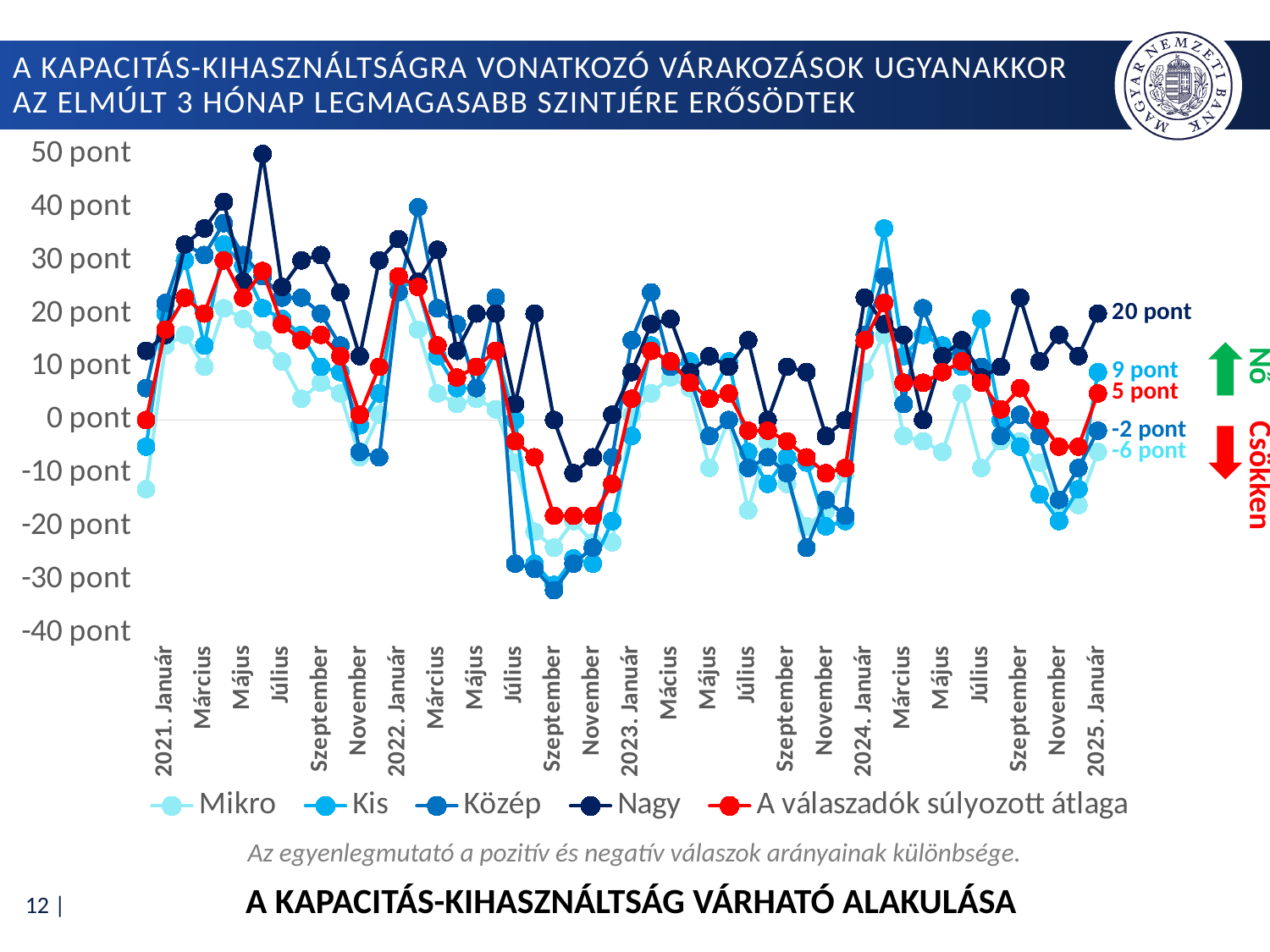
What value does the Közép series show at 2025. Január? -2 pont How many series does the legend list? 5 What value does the 'A válaszadók súlyozott átlaga' series show at 2025. Január? 5 pont What kind of chart is shown on the slide? line chart What value does the Mikro series show at 2025. Január? -6 pont What value does the Kis series show at 2025. Január? 9 pont What is the difference between the Nagy and Kis values at 2025. Január? 11 pont Is the value for Mikro at 2021. Január greater or less than 0 pont? greater Which series has the lowest value at 2025. Január? Mikro At 2025. Január, which is larger: the Kis value or the Közép value? Kis What value does the Nagy series show at 2025. Január? 20 pont Which series has the highest value at 2025. Január? Nagy